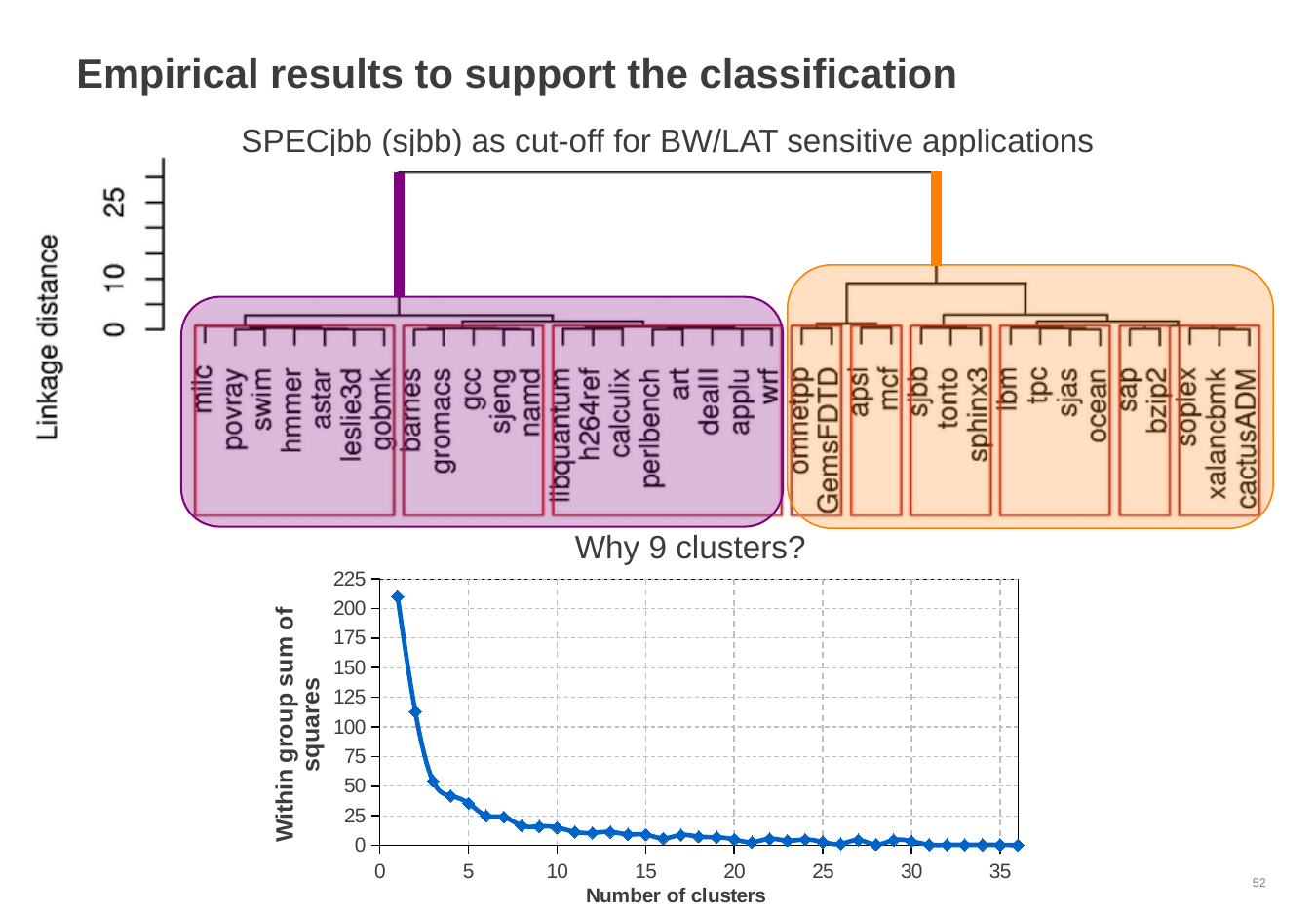
In the bottom chart "Why 9 clusters?", which is larger: the value for 3 clusters or the value for 20 clusters? 3 clusters In the bottom chart "Why 9 clusters?", is the within group sum of squares for 10 clusters greater or less than 25? less What is the x-axis label of the bottom chart "Why 9 clusters?"? Number of clusters In the bottom chart "Why 9 clusters?", is the within group sum of squares for 2 clusters greater or less than 100? greater In the top dendrogram chart, how many cluster boxes are outlined? 9 What is the y-axis label of the top dendrogram chart? Linkage distance In the bottom chart "Why 9 clusters?", is the within group sum of squares for 5 clusters greater or less than 50? less What kind of chart is the bottom chart titled "Why 9 clusters?"? line chart In the bottom chart "Why 9 clusters?", which number of clusters has the highest within group sum of squares? 1 In the top dendrogram chart, how many applications are listed in the orange group? 16 In the bottom chart "Why 9 clusters?", do the values rise or fall as the number of clusters increases? fall